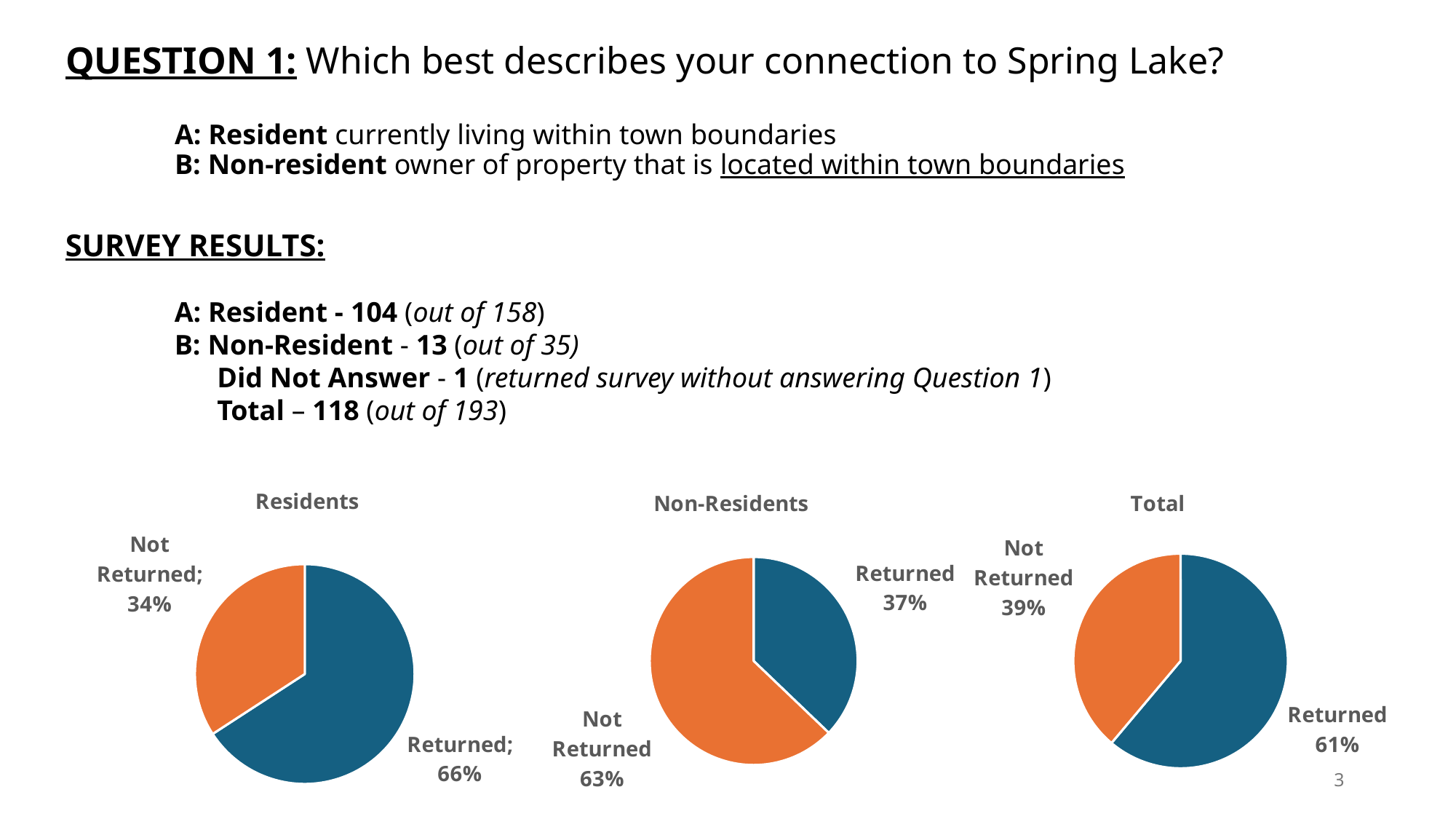
What kind of chart is used for the Residents chart? Pie chart In the Non-Residents pie chart, which slice is larger, Returned or Not Returned? Not Returned In the Residents pie chart, what share of surveys was Returned? 66% In the Total pie chart, what share of surveys was Not Returned? 39% In the Total pie chart, what share of surveys was Returned? 61% In the Residents pie chart, which slice is the largest? Returned How many pie charts are shown on the slide? 3 In the Total pie chart, what is the difference between the Returned and Not Returned shares? 22% How many slices does the Non-Residents pie chart have? 2